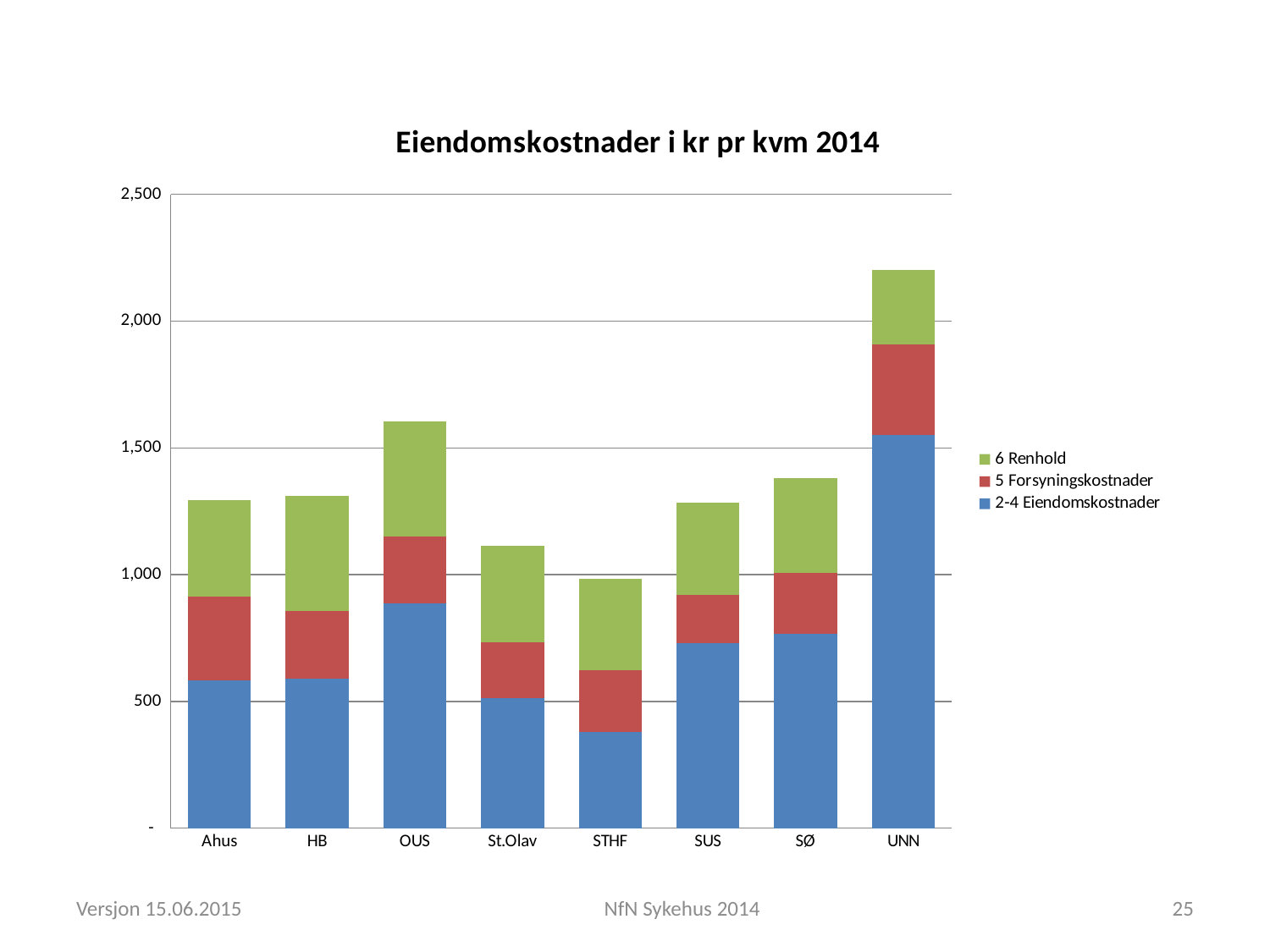
How many series does the legend list? 3 Which hospital has the lowest total bar? STHF Is the total bar for UNN greater or less than 2,000? greater What is the title of the chart? Eiendomskostnader i kr pr kvm 2014 Which hospital has the highest total bar? UNN Which has the larger total bar, OUS or SØ? OUS Which has the larger 2-4 Eiendomskostnader segment, OUS or Ahus? OUS Is the total bar for OUS greater or less than 1,500? greater Is the total bar for STHF greater or less than 1,000? less How many hospitals (categories) are shown on the x axis? 8 What kind of chart is shown on the slide? Stacked bar chart